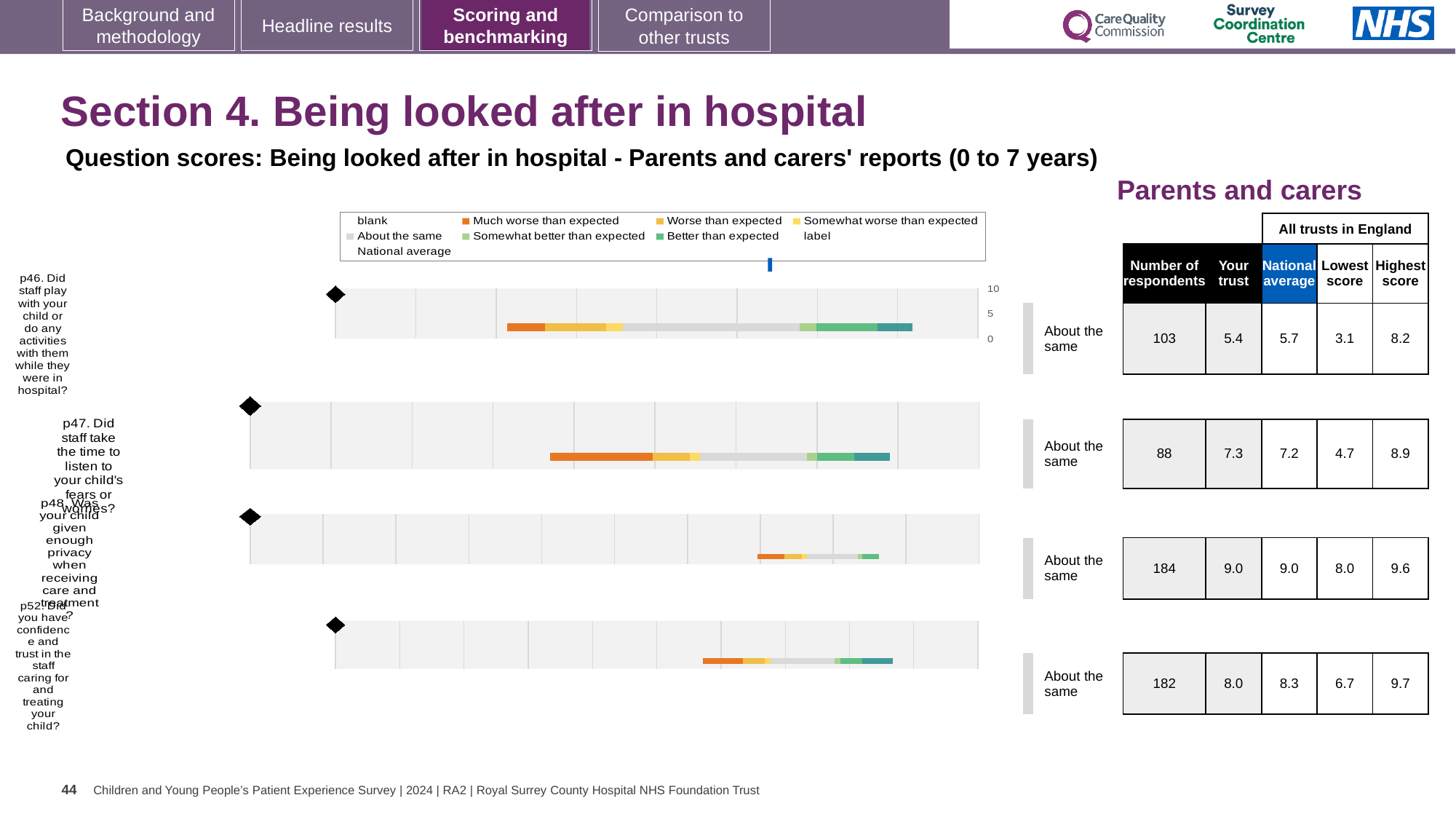
Which colour does the legend use for 'Much worse than expected'? Orange How many respondents are recorded for p48 (Was your child given enough privacy when receiving care and treatment?)? 184 What is the 'Your trust' score for p46 (Did staff play with your child or do any activities with them while they were in hospital?)? 5.4 Which question has the lowest 'Your trust' score? p46 How many survey questions (bars) are plotted on the slide? 4 What kind of chart is used to show the question scores on this slide? bar chart What benchmark category is shown for all four questions on the slide? About the same What is the national average score for p47 (Did staff take the time to listen to your child's fears or worries?)? 7.2 What is the highest score across all trusts in England for p52 (Did you have confidence and trust in the staff caring for and treating your child?)? 9.7 For p52, which is larger: the 'Your trust' score or the national average? National average Which question has the highest 'Your trust' score? p48 For p47, what is the difference between the 'Your trust' score and the national average? 0.1